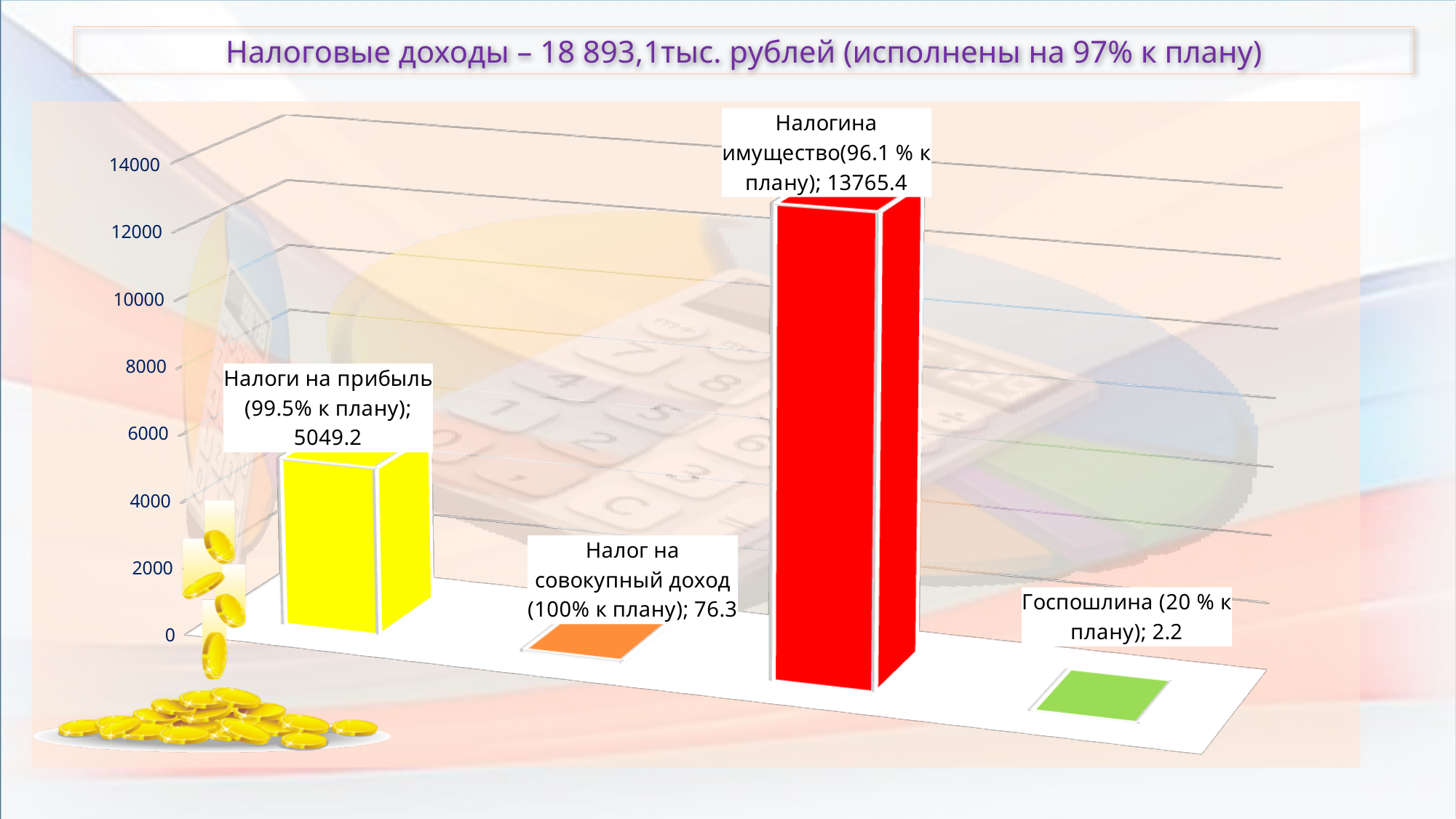
What is the value for Налоги на прибыль? 5049.2 What is the value for Госпошлина? 2.2 What is the difference between the values for Налог на имущество and Налоги на прибыль? 8716.2 Which category has the highest value? Налог на имущество What is the difference between the values for Налог на совокупный доход and Госпошлина? 74.1 What is the value for Налог на имущество? 13765.4 What is the value for Налог на совокупный доход? 76.3 Which category has the lowest value? Госпошлина How many categories are shown in the chart? 4 What kind of chart is shown on the slide? bar chart Is the value for Налоги на прибыль greater or less than 4000? greater Which is larger, the value for Налоги на прибыль or the value for Налог на совокупный доход? Налоги на прибыль